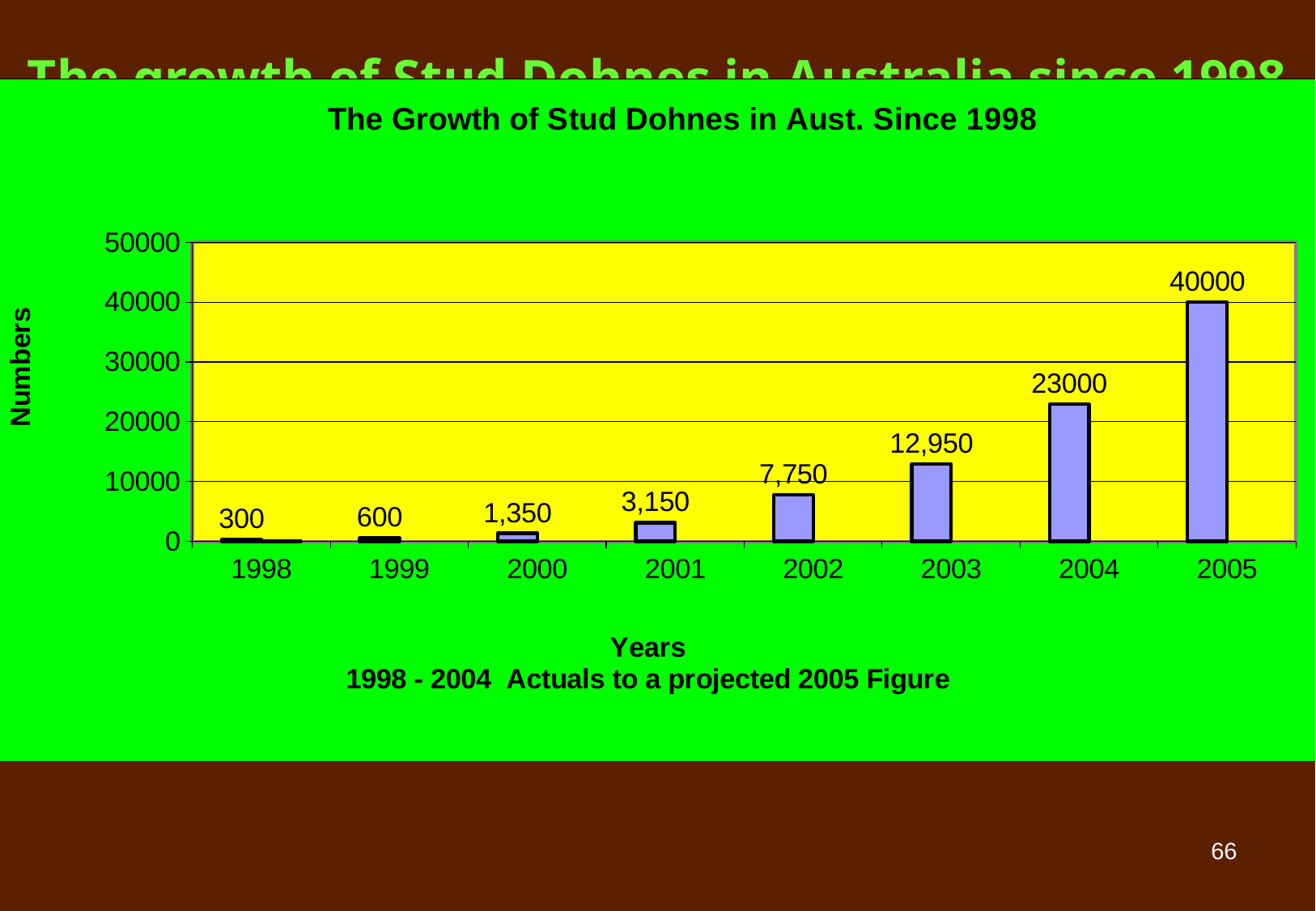
What is the difference between the values for 2003 and 2002? 5,200 Which is larger, the value for 2002 or the value for 2001? 2002 How many years are shown on the x axis? 8 What is the value for 2003? 12,950 Which year has the lowest value? 1998 What is the value for 1998? 300 Is the value for 2004 greater or less than 20000? greater Which year has the highest value? 2005 What kind of chart is this? bar chart Do the values rise or fall from 1998 to 2005? rise What is the difference between the values for 2005 and 2004? 17000 What is the value for 2001? 3,150